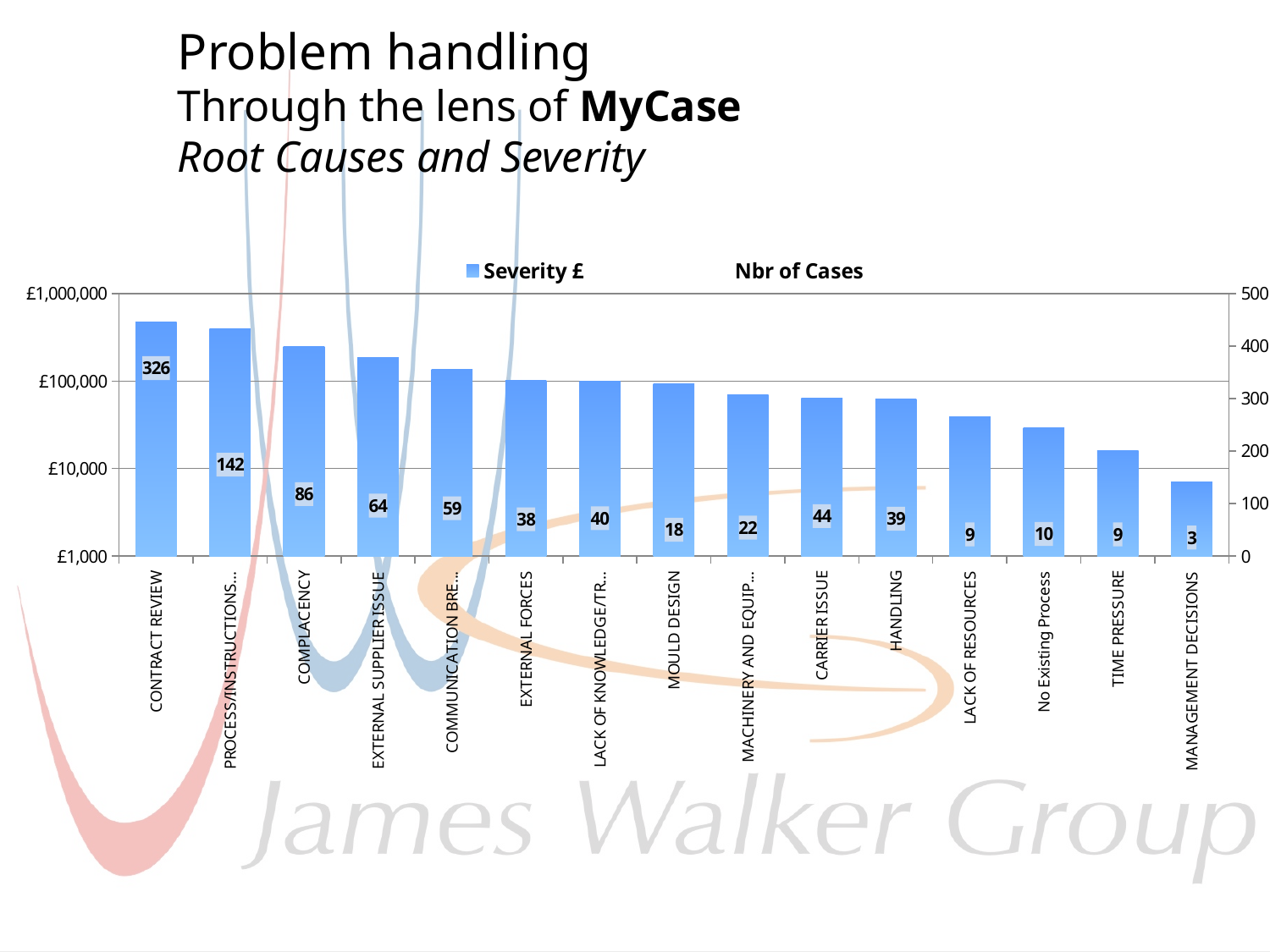
What is the number of cases labelled on the COMPLACENCY bar? 86 Is the Severity £ value for MANAGEMENT DECISIONS greater or less than £10,000? less Which category has the lowest number of cases? MANAGEMENT DECISIONS Which category has the highest number of cases? CONTRACT REVIEW How many series does the chart legend list? 2 What is the number of cases labelled on the CONTRACT REVIEW bar? 326 What kind of chart is shown on the slide? bar chart How many root-cause categories are plotted along the x axis? 15 What is the number of cases labelled on the MOULD DESIGN bar? 18 What is the difference in number of cases between CONTRACT REVIEW and COMPLACENCY? 240 Which has more cases, CARRIER ISSUE or HANDLING? CARRIER ISSUE Do the Severity £ bars rise or fall from left to right along the x axis? fall